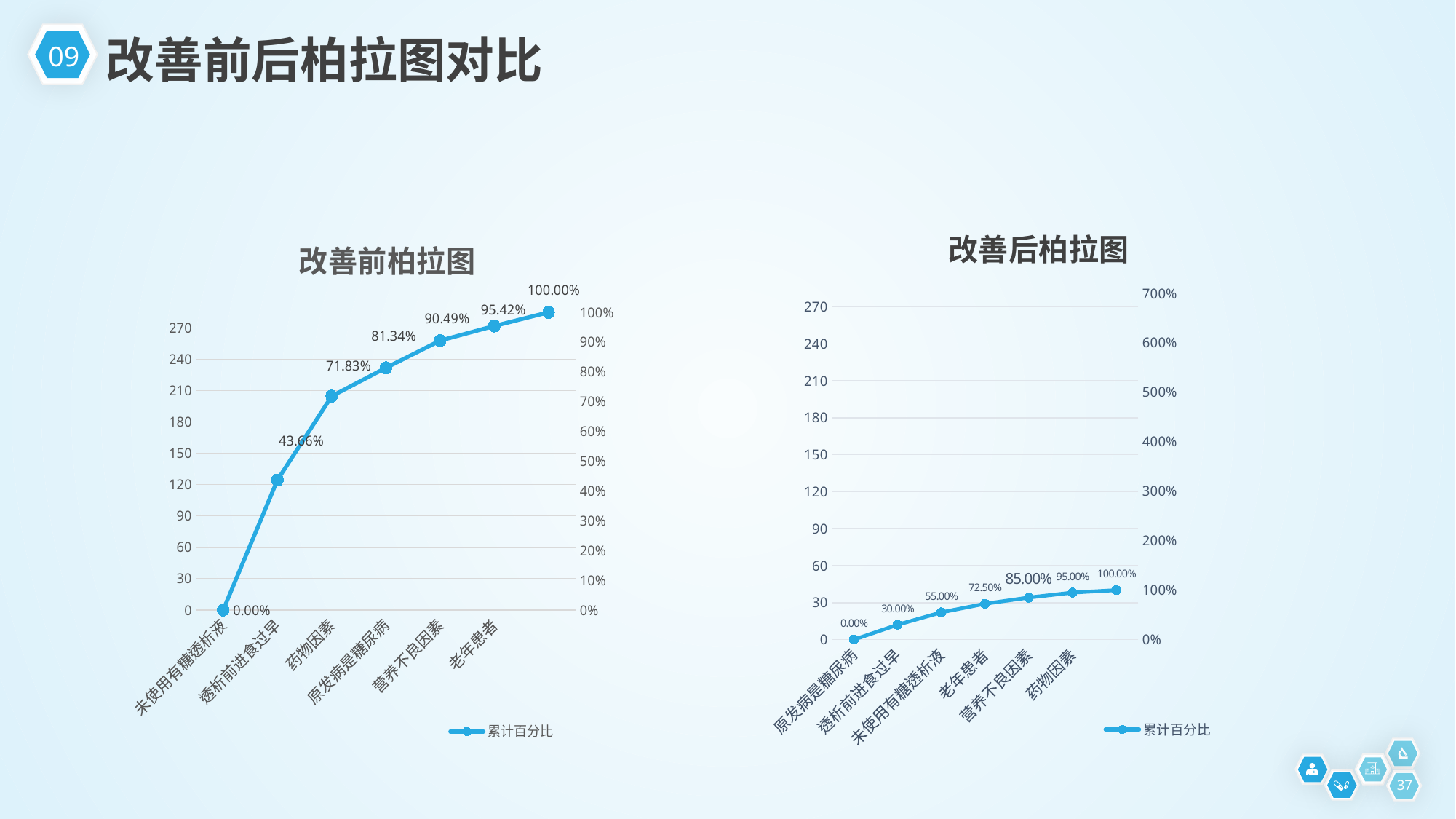
In the 改善后柏拉图 chart, do the plotted values rise or fall from left to right along the x axis? rise In the 改善前柏拉图 chart, what is the cumulative percentage value for 透析前进食过早? 43.66% In the 改善后柏拉图 chart, what is the difference between the values for 老年患者 and 透析前进食过早? 42.50% In the 改善前柏拉图 chart, what is the difference between the values for 原发病是糖尿病 and 药物因素? 9.51% In the 改善后柏拉图 chart, what is the cumulative percentage value for 营养不良因素? 85.00% Which is larger: the value for 透析前进食过早 in the 改善前柏拉图 chart or in the 改善后柏拉图 chart? 改善前柏拉图 In the 改善前柏拉图 chart, what is the cumulative percentage value for 老年患者? 95.42% In the 改善前柏拉图 chart, what is the cumulative percentage value for 药物因素? 71.83% What kind of chart is the 改善前柏拉图 chart? line chart In the 改善后柏拉图 chart, what is the cumulative percentage value for 未使用有糖透析液? 55.00% What series name does the legend of the 改善后柏拉图 chart show? 累计百分比 In the 改善后柏拉图 chart, what is the cumulative percentage value for 药物因素? 95.00%